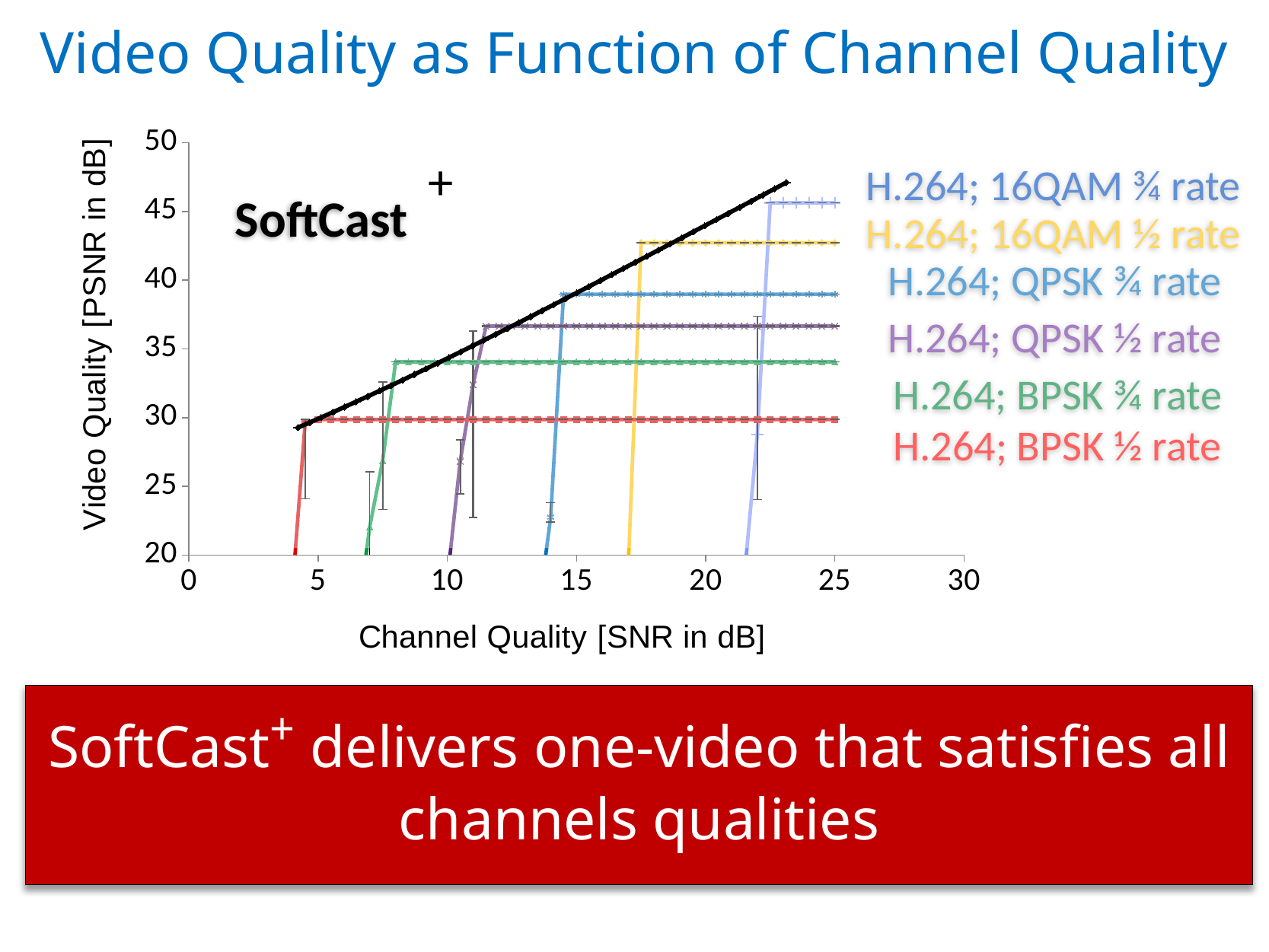
Which H.264 configuration reaches the highest video quality plateau? H.264; 16QAM ¾ rate Does the SoftCast+ curve rise or fall as channel quality (SNR) increases? rise What kind of chart is shown on the slide? line chart Is the plateau video quality of H.264; QPSK ½ rate greater or less than 35 dB PSNR? greater Is the SoftCast+ video quality at a channel SNR of 20 dB greater or less than 40 dB PSNR? greater What is the label of the x axis of the chart? Channel Quality [SNR in dB] Is the plateau video quality of H.264; BPSK ¾ rate greater or less than 35 dB PSNR? less What is the title of the chart on the slide? Video Quality as Function of Channel Quality How many H.264 configurations are listed in the legend to the right of the chart? 6 Which H.264 configuration has the lowest video quality plateau? H.264; BPSK ½ rate Which has the higher plateau video quality: H.264; QPSK ¾ rate or H.264; BPSK ¾ rate? H.264; QPSK ¾ rate